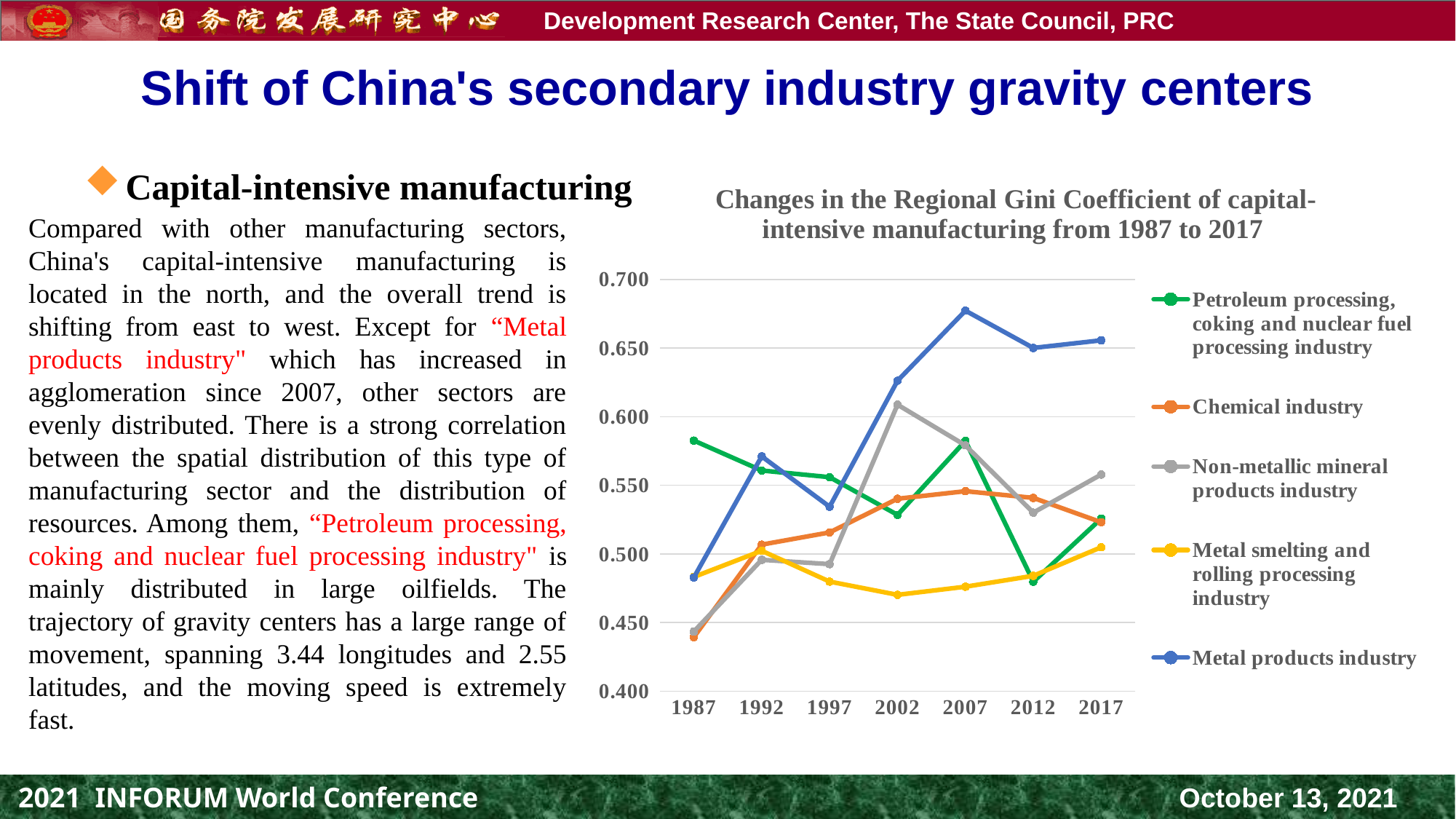
In 2017, which is larger: the value for Metal products industry or the value for Chemical industry? Metal products industry Is the value for Petroleum processing, coking and nuclear fuel processing industry in 1987 greater or less than 0.550? greater What is the title of the chart? Changes in the Regional Gini Coefficient of capital-intensive manufacturing from 1987 to 2017 Is the value for Metal smelting and rolling processing industry in 2002 greater or less than 0.500? less Which industry has the lowest Gini coefficient in 2007? Metal smelting and rolling processing industry Which industry has the highest Gini coefficient in 2007? Metal products industry Is the value for Metal products industry in 2007 greater or less than 0.650? greater What kind of chart is shown on the slide? line chart How many series does the legend list? 5 Does the value for Metal products industry rise or fall from 1997 to 2007? rise Which industry has the lowest Gini coefficient in 2017? Metal smelting and rolling processing industry How many years are shown on the x axis? 7